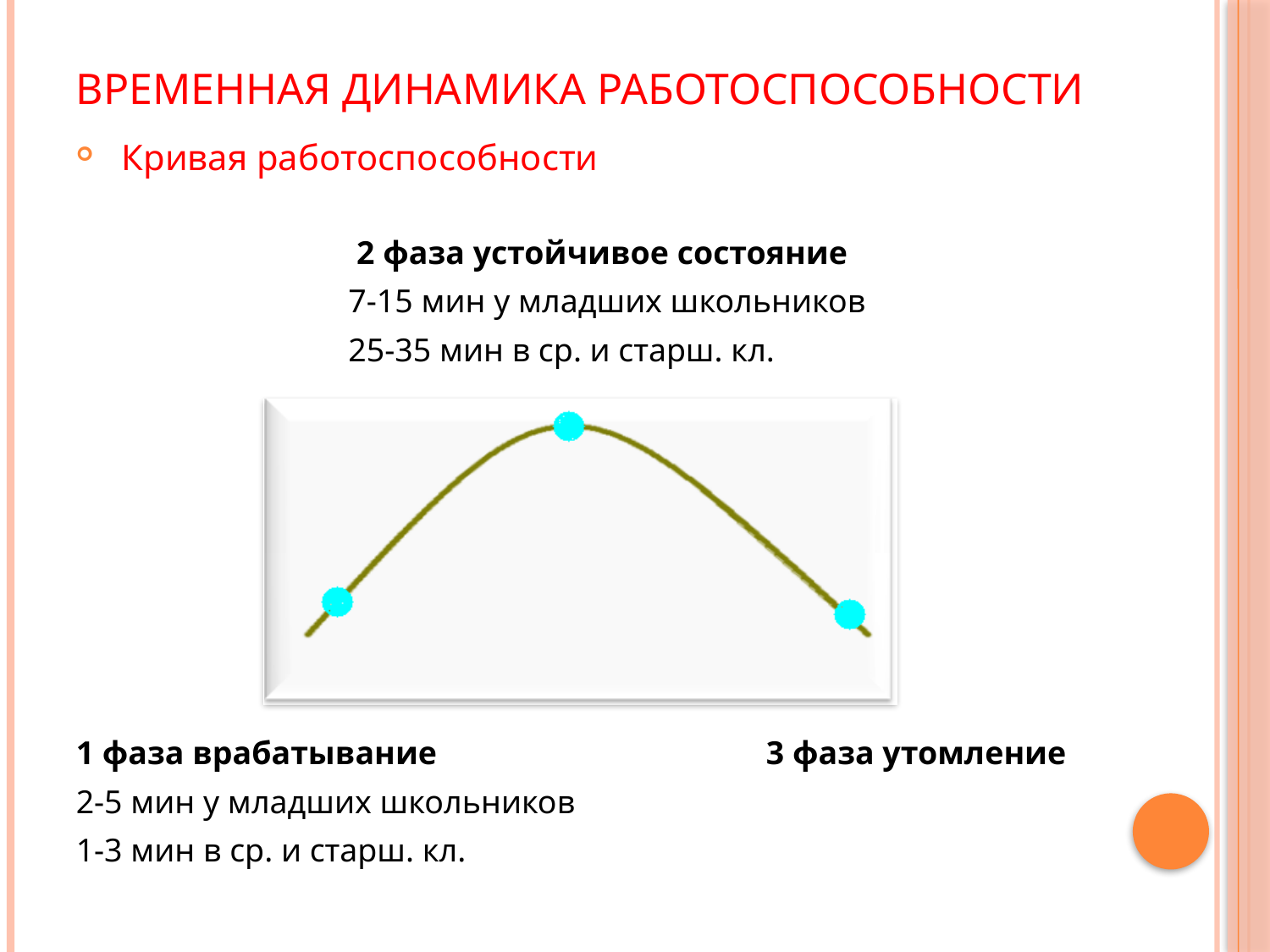
What colour are the marked points on the curve? cyan Which marked point on the curve is the highest: the first, the middle, or the last? the middle What is the name of the curve given in the bullet above the chart? Кривая работоспособности Which is higher on the curve, the first marked point or the last marked point? the first marked point How many marked points are there on the curve? 3 Does the curve rise or fall from the middle marked point to the last marked point? fall What kind of chart is shown on the slide? line chart Does the curve rise or fall from the first marked point to the middle marked point? rise